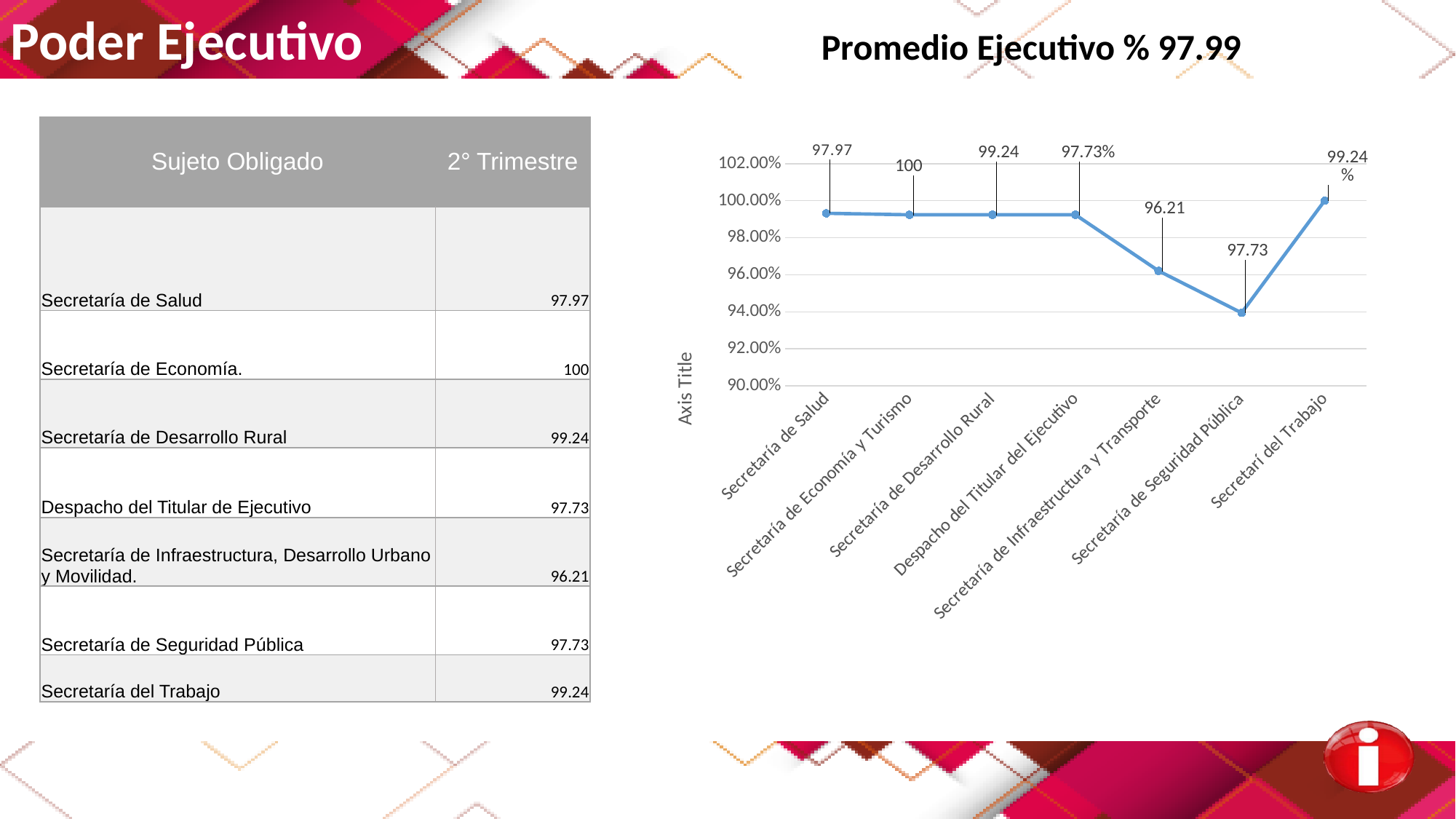
How many categories are plotted along the x axis of the chart? 7 What is the title shown on the vertical axis of the chart? Axis Title What is the data label for Secretaría de Economía y Turismo in the chart? 100 What is the data label for Secretaría de Salud in the chart? 97.97 What is the data label for Despacho del Titular del Ejecutivo in the chart? 97.73% What kind of chart is shown on the slide? line chart What is the data label for Secretaría de Desarrollo Rural in the chart? 99.24 Which has the larger value, Secretaría de Salud or Secretaría de Infraestructura y Transporte? Secretaría de Salud What is the difference between the labelled values for Secretaría de Economía y Turismo and Secretaría de Salud? 2.03 What is the data label for Secretaría de Infraestructura y Transporte in the chart? 96.21 Is the plotted value for Secretaría de Infraestructura y Transporte greater or less than 98.00%? less Does the line rise or fall from Despacho del Titular del Ejecutivo to Secretaría de Seguridad Pública? fall